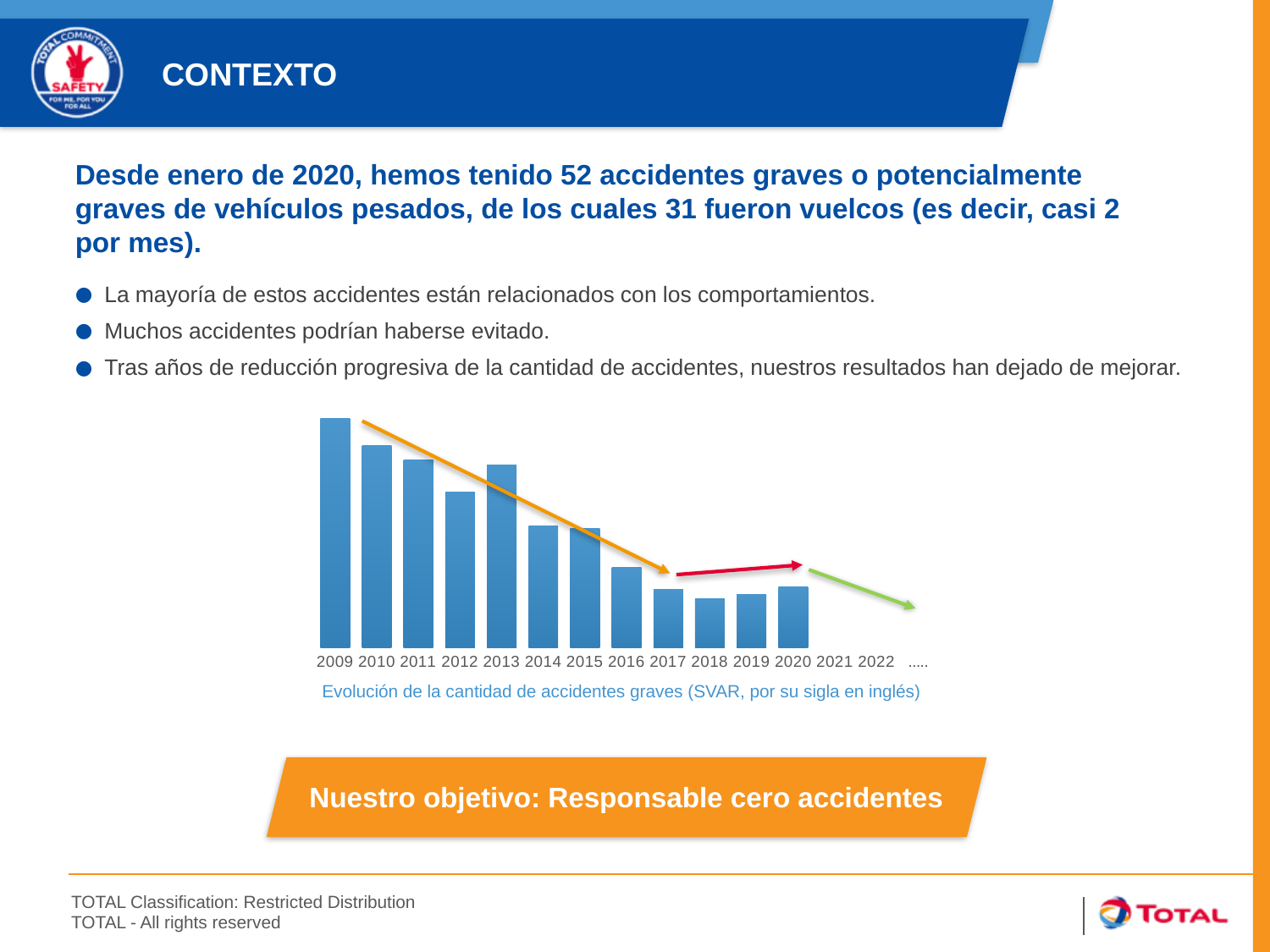
Which bar is taller, 2012 or 2013? 2013 Which bar is taller, 2015 or 2016? 2015 Which bar is taller, 2014 or 2017? 2014 How many bars are plotted in the chart? 12 What is the caption/title of the chart? Evolución de la cantidad de accidentes graves (SVAR, por su sigla en inglés) Which year has the tallest bar in the chart? 2009 What is the first year labelled on the x axis of the chart? 2009 Do the bar values generally rise or fall from 2009 to 2018? fall What kind of chart is shown on the slide? bar chart